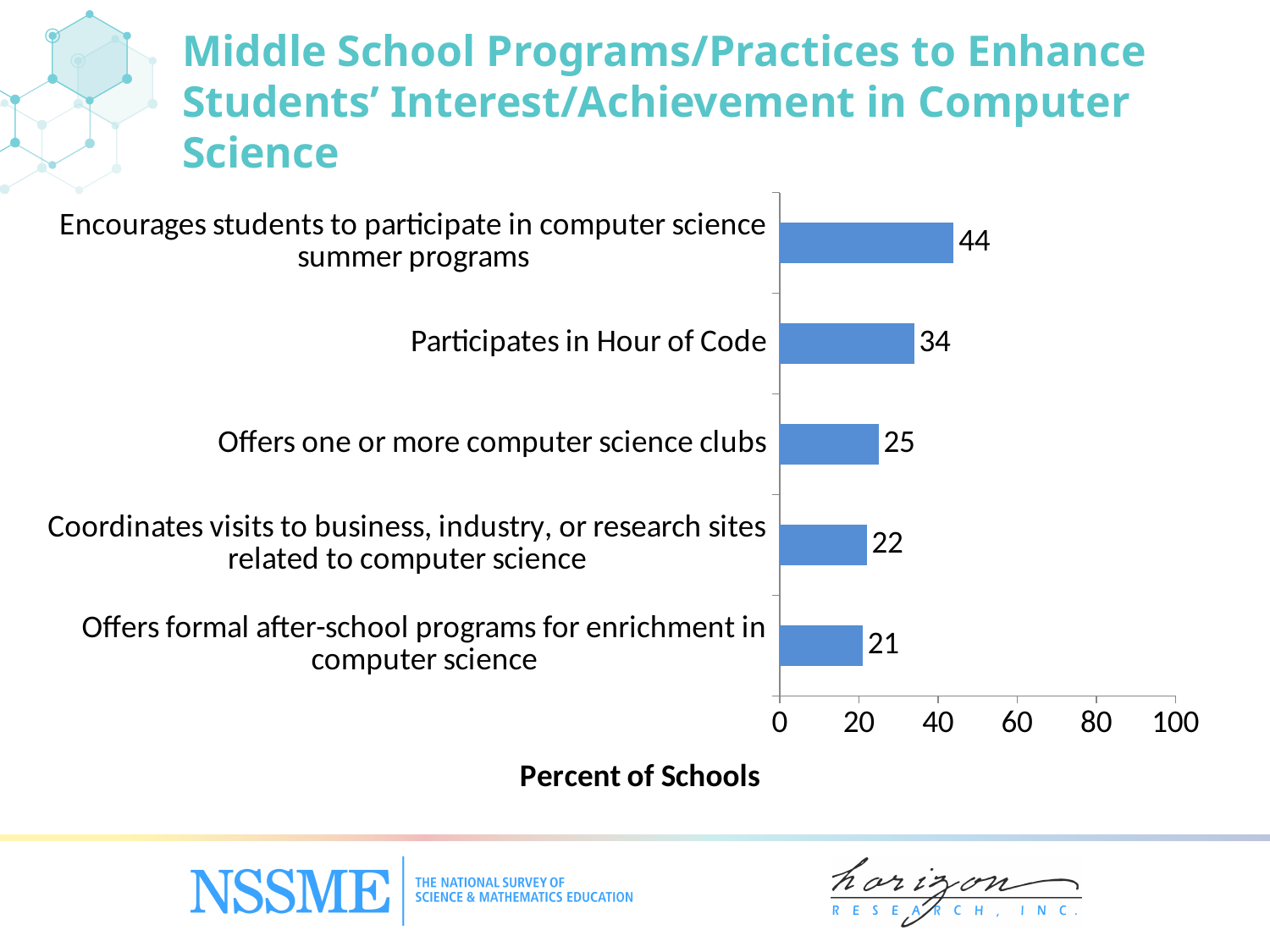
What kind of chart is shown on the slide? Bar chart What percent of schools offer formal after-school programs for enrichment in computer science? 21 How many programs/practices are shown in the chart? 5 Which program/practice has the lowest percent of schools? Offers formal after-school programs for enrichment in computer science What percent of schools participate in Hour of Code? 34 What is the difference in percent of schools between encouraging participation in computer science summer programs and participating in Hour of Code? 10 What percent of schools offer one or more computer science clubs? 25 Which program/practice has the highest percent of schools? Encourages students to participate in computer science summer programs What is the label of the horizontal axis? Percent of Schools What percent of schools coordinate visits to business, industry, or research sites related to computer science? 22 Which has a higher percent of schools: offering one or more computer science clubs or participating in Hour of Code? Participates in Hour of Code What percent of schools encourage students to participate in computer science summer programs? 44